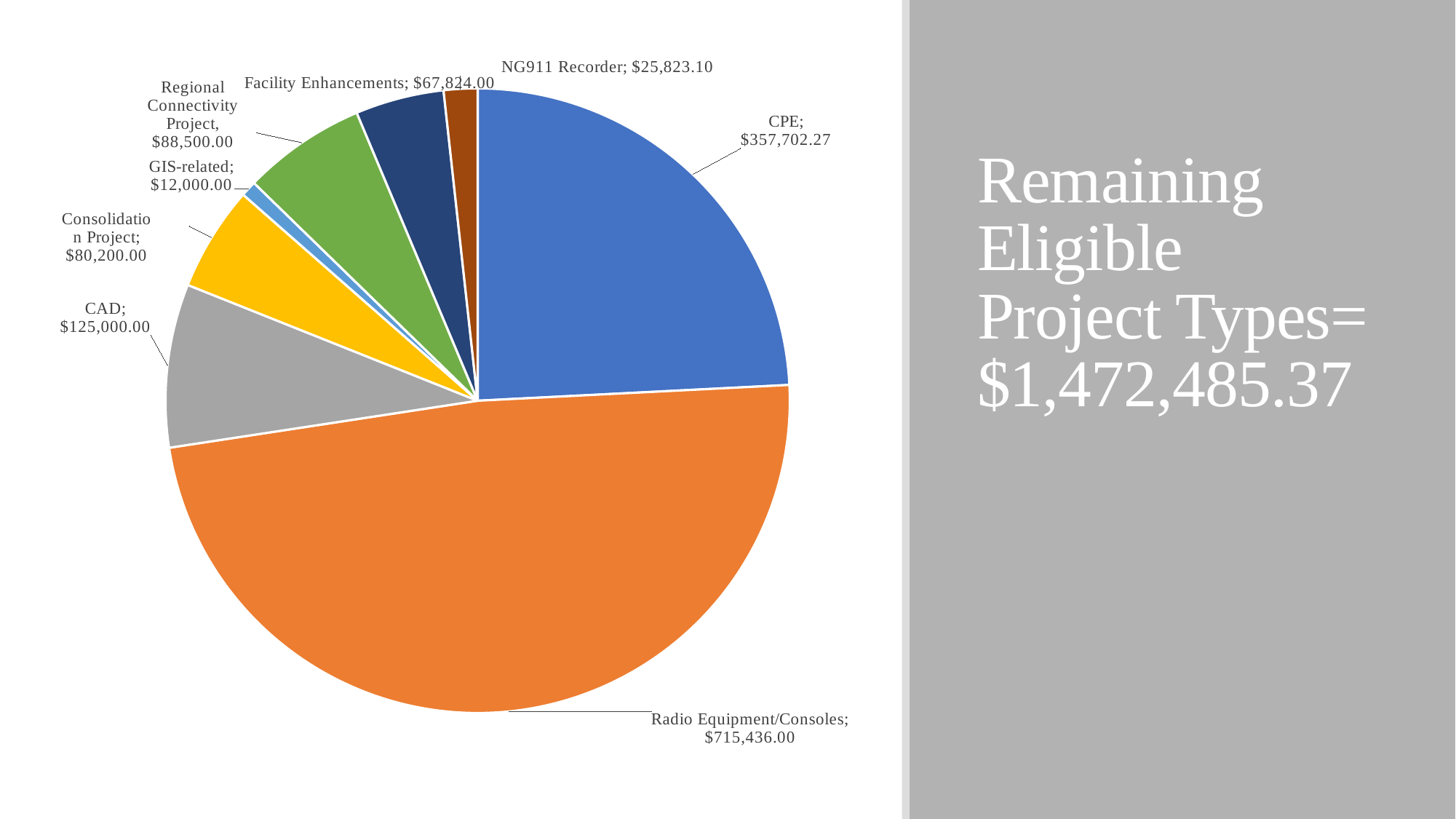
What is the value for NG911 Recorder? $25,823.10 What is the value for Radio Equipment/Consoles? $715,436.00 What is the difference between the Radio Equipment/Consoles value and the CPE value? $357,733.73 What total amount of remaining eligible project types is stated on the slide? $1,472,485.37 What is the value for GIS-related? $12,000.00 What is the difference between the CAD value and the Consolidation Project value? $44,800.00 What is the value for CPE? $357,702.27 Which category has the smallest slice of the pie? GIS-related How many categories are shown in the pie chart? 8 What type of chart is shown on the slide? Pie chart Which category has the largest slice of the pie? Radio Equipment/Consoles Which is larger, the Regional Connectivity Project value or the Facility Enhancements value? Regional Connectivity Project